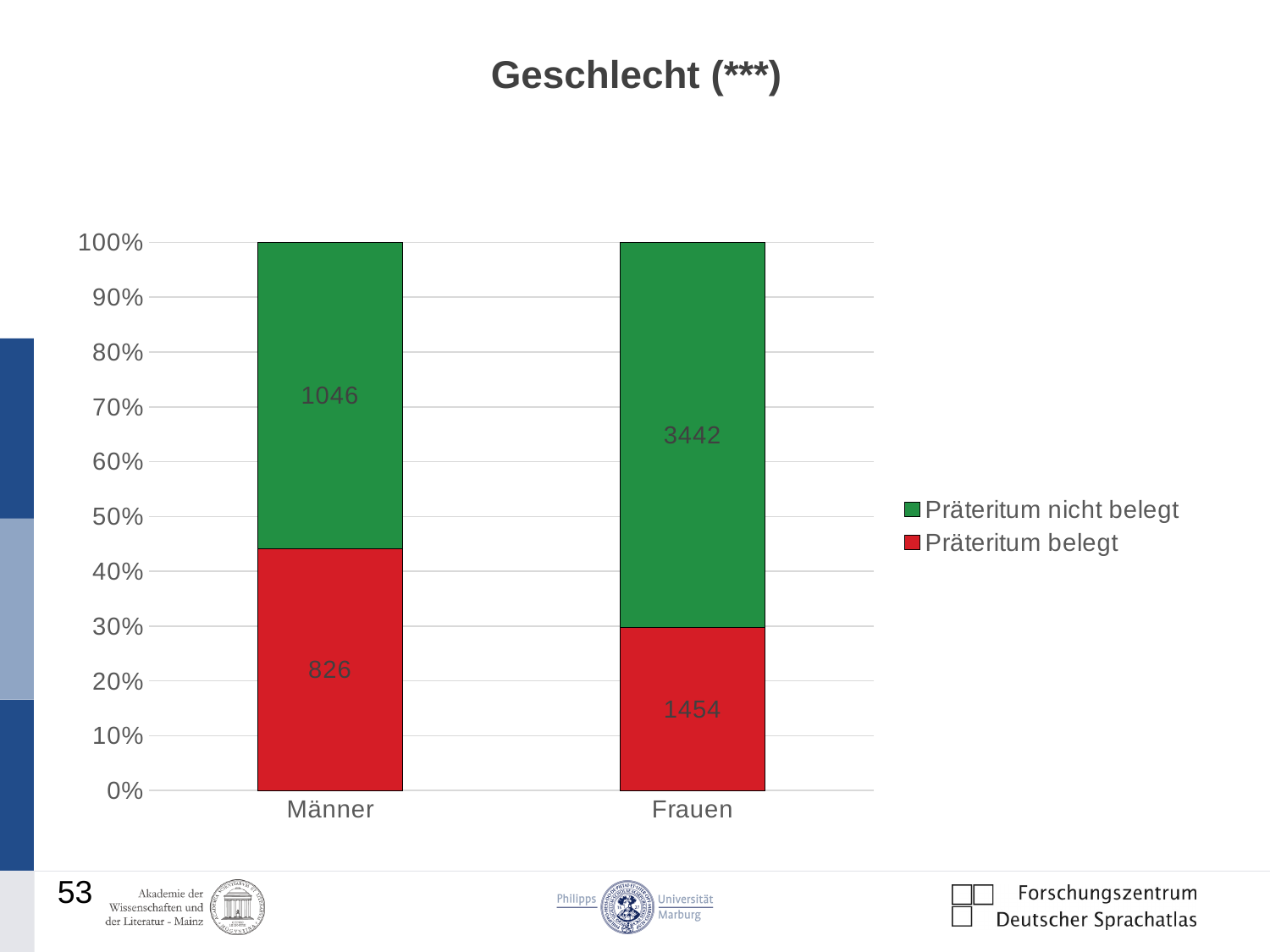
What is the value for Präteritum belegt for Frauen? 1454 What is the difference between the Präteritum belegt values for Frauen and Männer? 628 How many categories are shown on the x axis? 2 Is the share of Präteritum belegt for Männer greater or less than 40%? greater What is the value for Präteritum belegt for Männer? 826 What is the value for Präteritum nicht belegt for Männer? 1046 What is the total of the two values labelled in the Frauen bar? 4896 Which category has the higher value for Präteritum nicht belegt, Männer or Frauen? Frauen How many series does the legend list? 2 What is the total of the two values labelled in the Männer bar? 1872 What is the value for Präteritum nicht belegt for Frauen? 3442 What type of chart is shown on the slide? Stacked bar chart